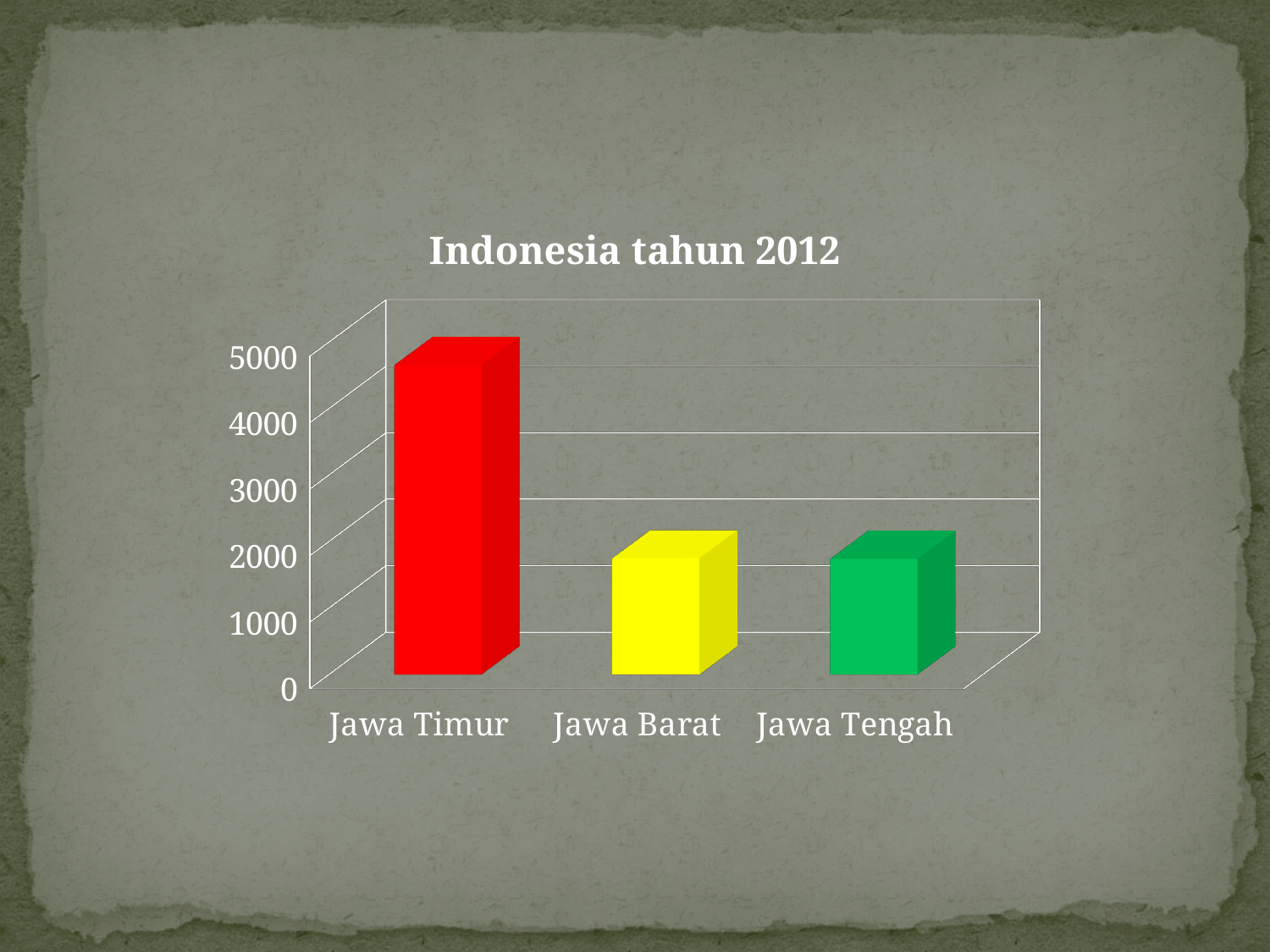
Is the value for Jawa Tengah greater or less than 1000? greater Which is larger, the value for Jawa Timur or the value for Jawa Barat? Jawa Timur How many categories are shown on the x axis of the chart? 3 What is the title of the chart? Indonesia tahun 2012 Is the value for Jawa Tengah greater or less than 3000? less Is the value for Jawa Timur greater or less than 4000? greater Which category has the highest value in the chart? Jawa Timur Which is larger, the value for Jawa Timur or the value for Jawa Tengah? Jawa Timur What kind of chart is shown on the slide? bar chart What colour is the bar for Jawa Tengah? green